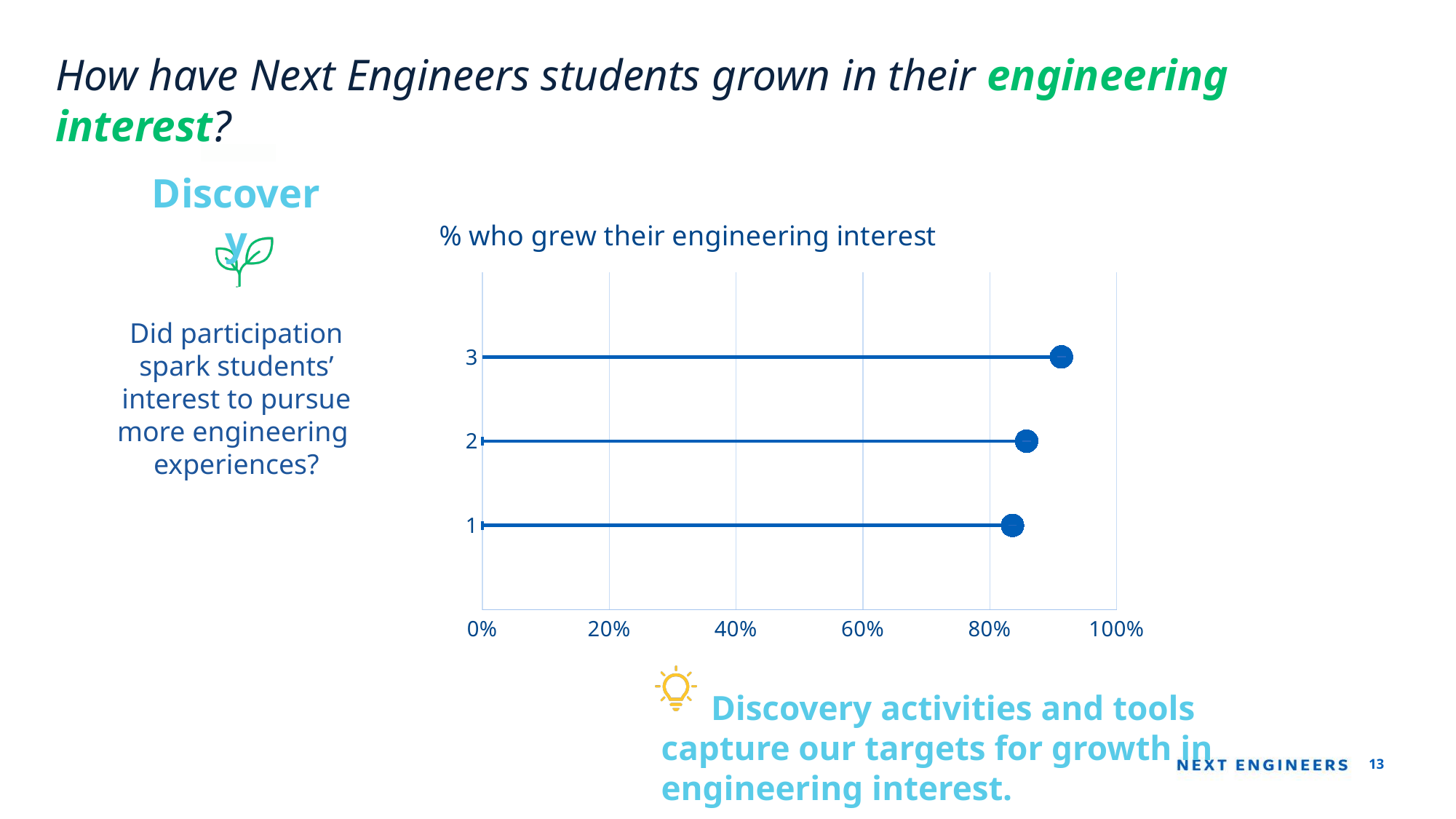
Is the value for category 2 greater or less than 100%? less Is the value for category 1 greater or less than 80%? greater Is the value for category 3 greater or less than 100%? less Which is larger, the value for category 3 or the value for category 2? Category 3 How many categories are plotted on the chart? 3 What is the highest value shown on the chart's horizontal axis? 100% Which category has the highest value on the chart? 3 What is the title of the chart? % who grew their engineering interest Do the values increase or decrease going from category 1 to category 3? increase